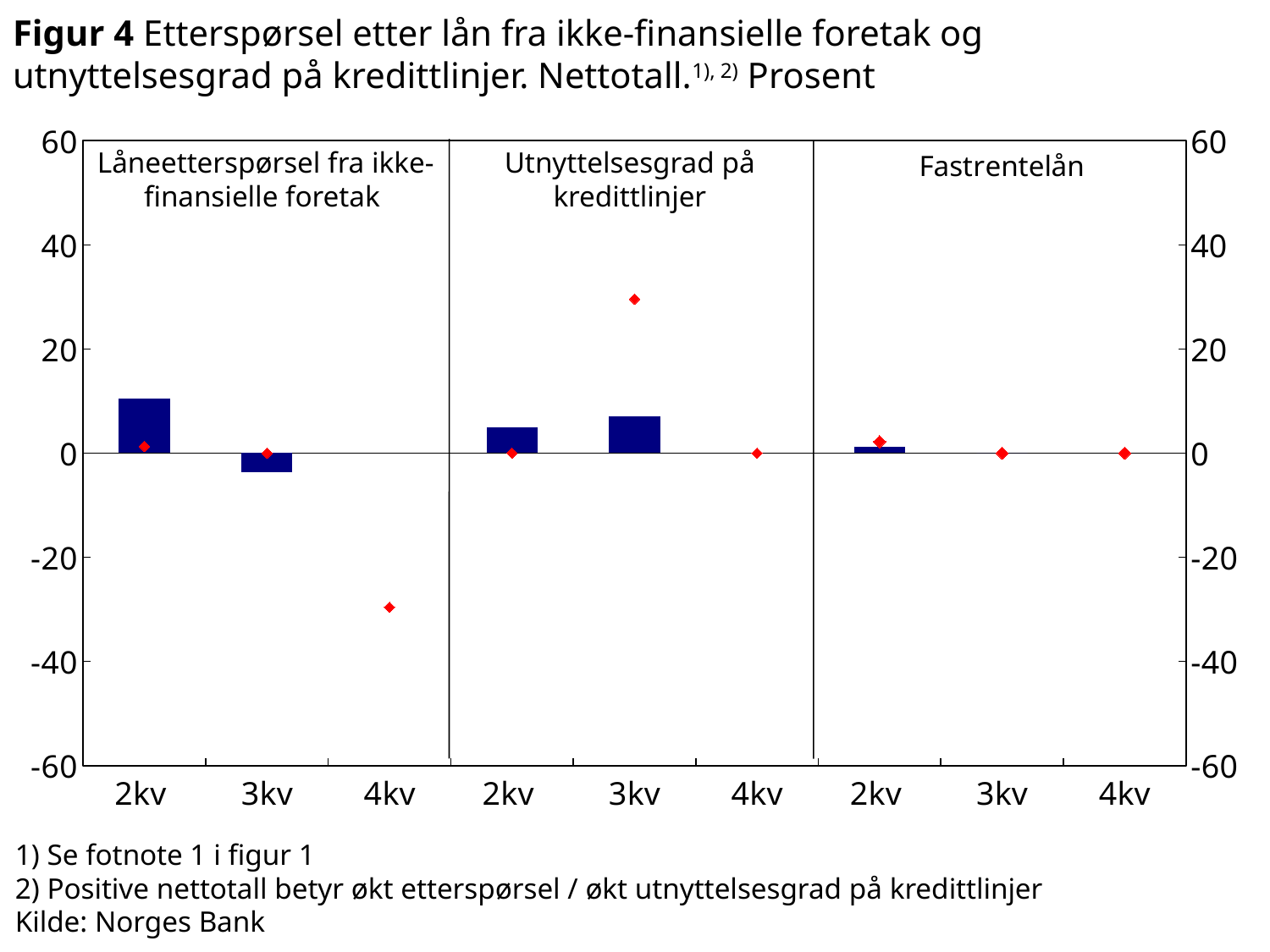
How many quarters are shown on the x axis within each panel of Figur 4? 3 What source is given for Figur 4? Norges Bank In the 'Utnyttelsesgrad på kredittlinjer' panel, is the red marker for 3kv greater or less than 20? greater What kind of chart is shown in Figur 4? combination bar and line chart (bars with red diamond markers) How many panels (sections) does the chart in Figur 4 have? 3 In the 'Utnyttelsesgrad på kredittlinjer' panel, is the red marker for 3kv greater or less than 40? less In the 'Låneetterspørsel fra ikke-finansielle foretak' panel, which quarter has the lowest bar? 3kv In the 'Låneetterspørsel fra ikke-finansielle foretak' panel, which quarter has the highest bar? 2kv What is the title of the rightmost panel in Figur 4? Fastrentelån In the 'Låneetterspørsel fra ikke-finansielle foretak' panel, is the bar for 2kv greater or less than 20? less In the 'Låneetterspørsel fra ikke-finansielle foretak' panel, which bar is larger, 2kv or 3kv? 2kv